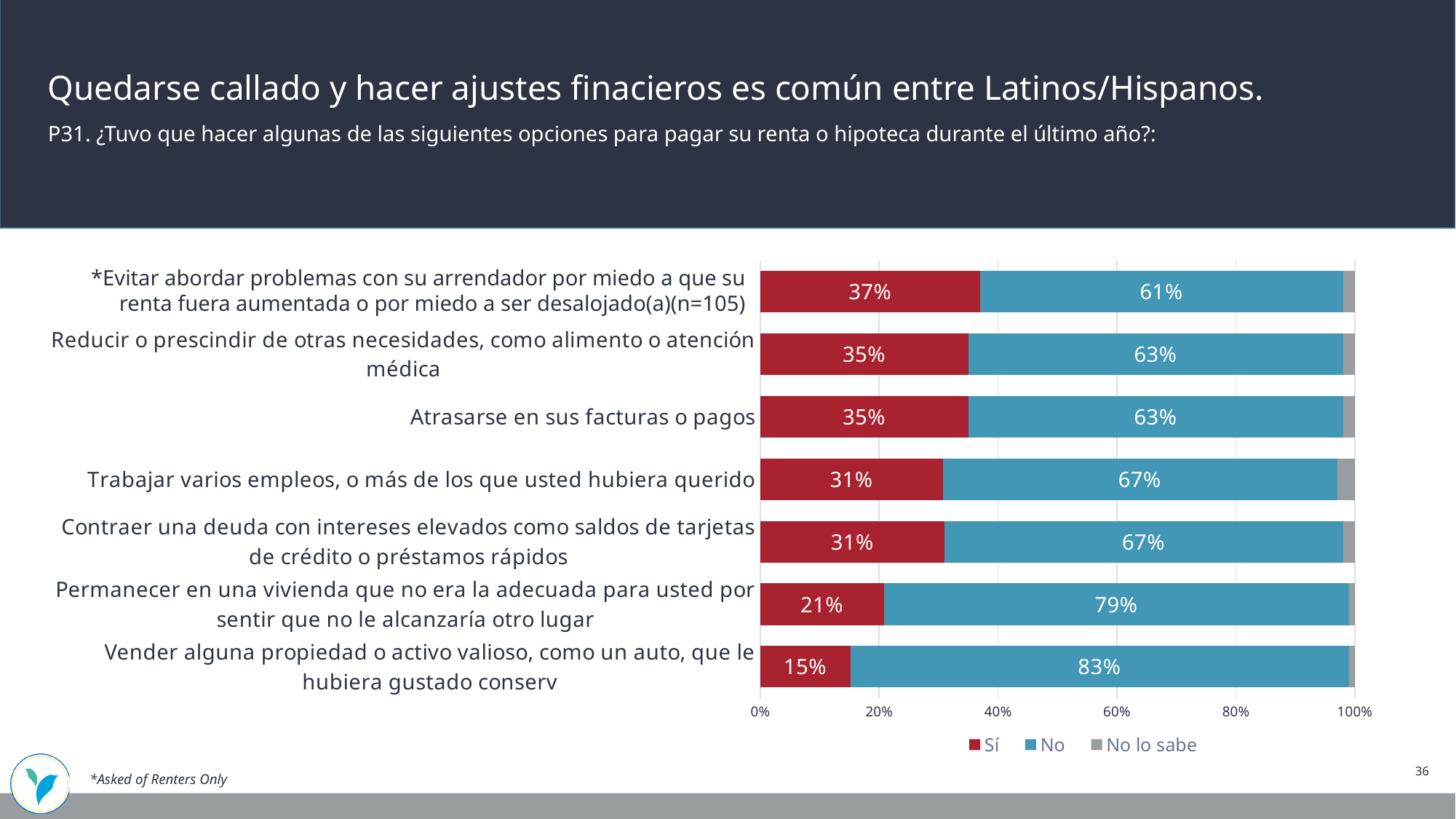
Which category has the lowest "Sí" percentage? Vender alguna propiedad o activo valioso, como un auto, que le hubiera gustado conserv What is the "Sí" value for "Vender alguna propiedad o activo valioso, como un auto, que le hubiera gustado conserv"? 15% How many series does the legend list? 3 What colour represents the "Sí" series in the chart? Red What percentage answered "No" for "Permanecer en una vivienda que no era la adecuada para usted por sentir que no le alcanzaría otro lugar"? 79% What are the three legend entries of the chart? Sí, No, No lo sabe What percentage answered "Sí" for "Atrasarse en sus facturas o pagos"? 35% How many categories (response options) are shown in the chart? 7 Which category has the highest "Sí" percentage? *Evitar abordar problemas con su arrendador por miedo a que su renta fuera aumentada o por miedo a ser desalojado(a)(n=105) Which is larger: the "No" value for "Trabajar varios empleos, o más de los que usted hubiera querido" or the "No" value for "Reducir o prescindir de otras necesidades, como alimento o atención médica"? Trabajar varios empleos, o más de los que usted hubiera querido (67%) What is the difference in percentage points between the highest "Sí" value (37%) and the lowest "Sí" value (15%)? 22 percentage points What kind of chart is shown on the slide? Stacked bar chart